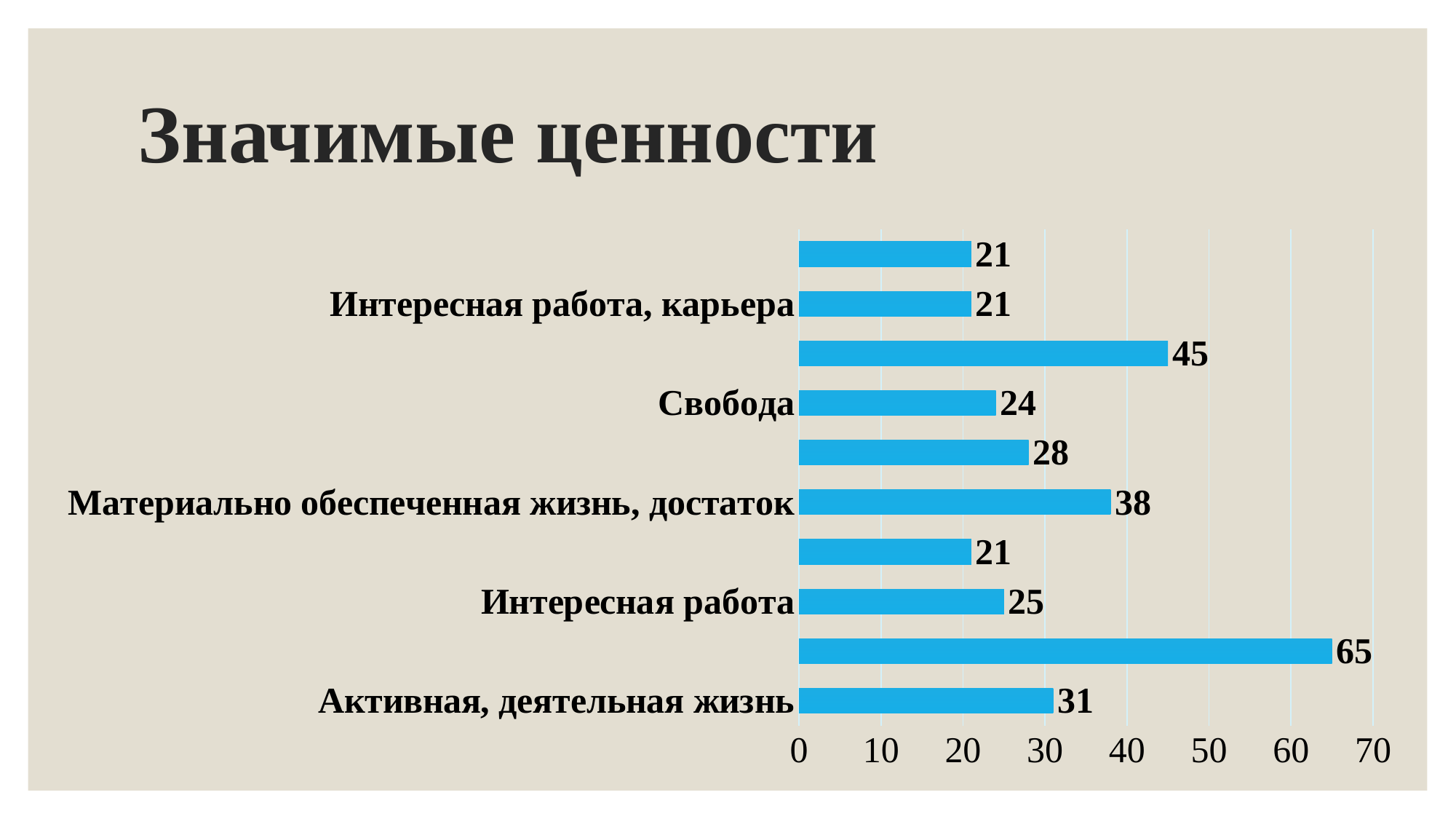
How many bars are plotted on the chart? 10 What is the difference between the values for Материально обеспеченная жизнь, достаток and Свобода? 14 What is the smallest value shown on the chart? 21 Which is larger: the value for Активная, деятельная жизнь or the value for Интересная работа? Активная, деятельная жизнь What kind of chart is shown on the slide? Bar chart What is the title of the slide? Значимые ценности What is the value for Материально обеспеченная жизнь, достаток? 38 What is the largest value shown on the chart? 65 What is the value for Интересная работа? 25 What is the value for Свобода? 24 What is the value for Активная, деятельная жизнь? 31 What is the value for Интересная работа, карьера? 21